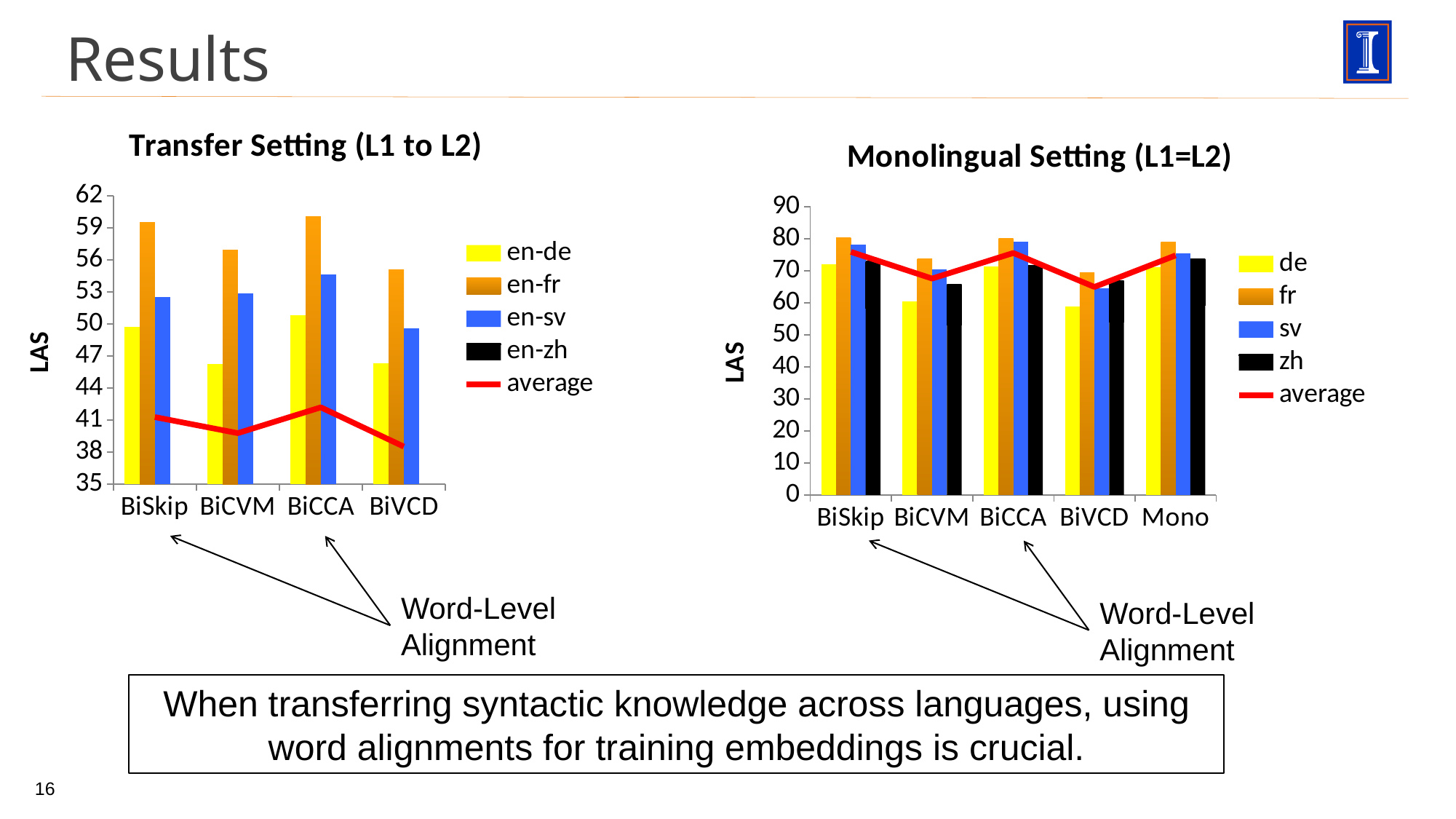
On the Transfer Setting (L1 to L2) chart, is the en-fr value for BiSkip greater or less than 56? greater On the Monolingual Setting (L1=L2) chart, is the zh value for BiCVM greater or less than 70? less On the Transfer Setting (L1 to L2) chart, how many categories are shown on the x axis? 4 On the Transfer Setting (L1 to L2) chart, which is larger for BiSkip, en-fr or en-sv? en-fr On the Monolingual Setting (L1=L2) chart, is the de value for BiVCD greater or less than 60? less On the Monolingual Setting (L1=L2) chart, how many entries does the legend list? 5 What is the y-axis label on the Transfer Setting (L1 to L2) chart? LAS On the Monolingual Setting (L1=L2) chart, which is larger for BiCVM, fr or zh? fr On the Transfer Setting (L1 to L2) chart, how many entries does the legend list? 5 On the Monolingual Setting (L1=L2) chart, how many categories are shown on the x axis? 5 What kind of chart is the Transfer Setting (L1 to L2) chart? Bar chart with a line for the average